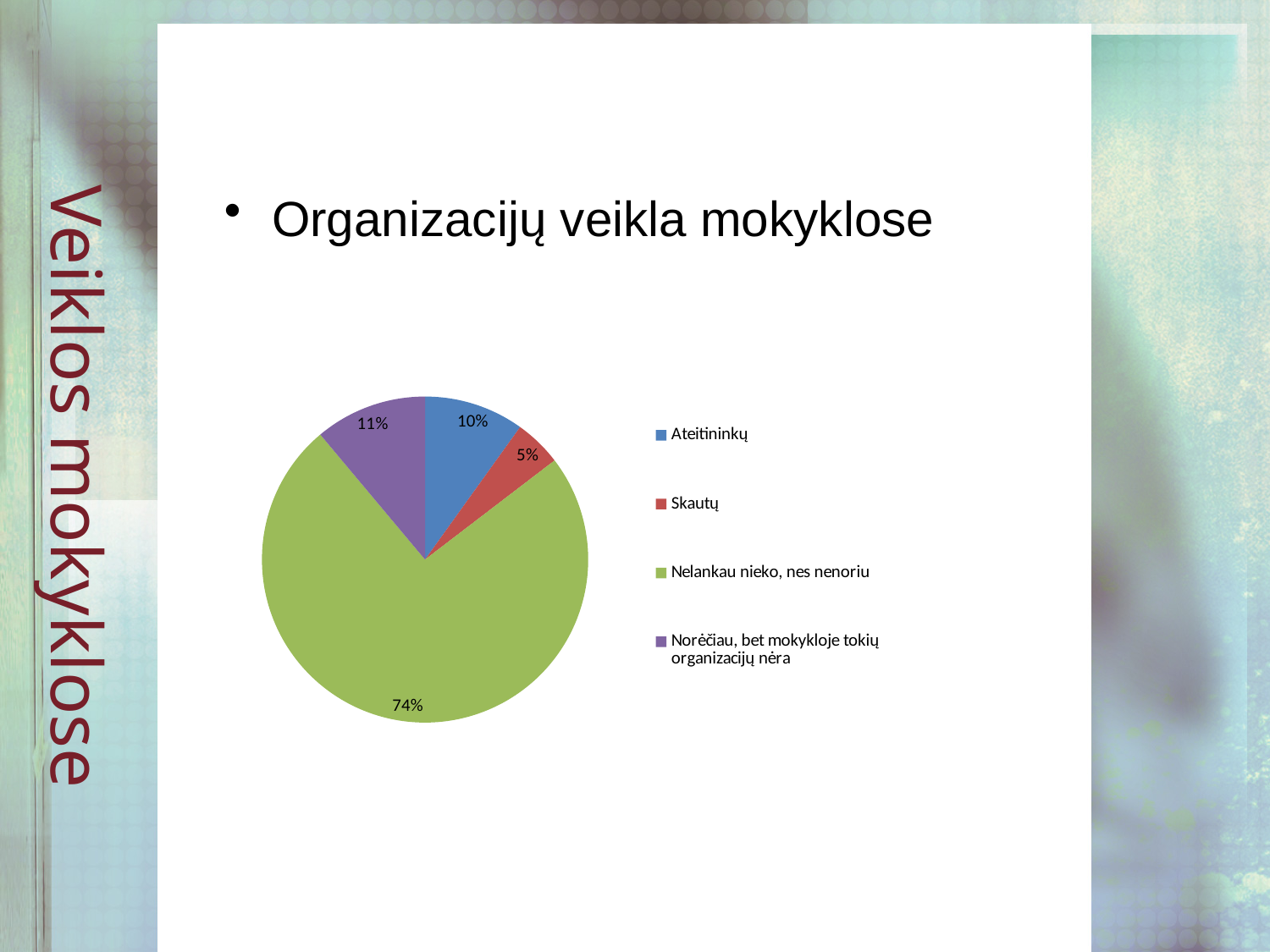
How many categories does the pie chart have? 4 How many entries does the legend list? 4 Which category has the smallest slice of the pie? Skautų Which is larger, the value for "Ateitininkų" or the value for "Norėčiau, bet mokykloje tokių organizacijų nėra"? Norėčiau, bet mokykloje tokių organizacijų nėra What colour is the slice for "Skautų"? red What is the value for "Skautų"? 5% What share of the pie does "Nelankau nieko, nes nenoriu" have? 74% What kind of chart is shown on the slide? pie chart Which category has the largest slice of the pie? Nelankau nieko, nes nenoriu What is the value for "Ateitininkų"? 10% What is the value for "Norėčiau, bet mokykloje tokių organizacijų nėra"? 11% What is the difference between the values for "Ateitininkų" and "Skautų"? 5%